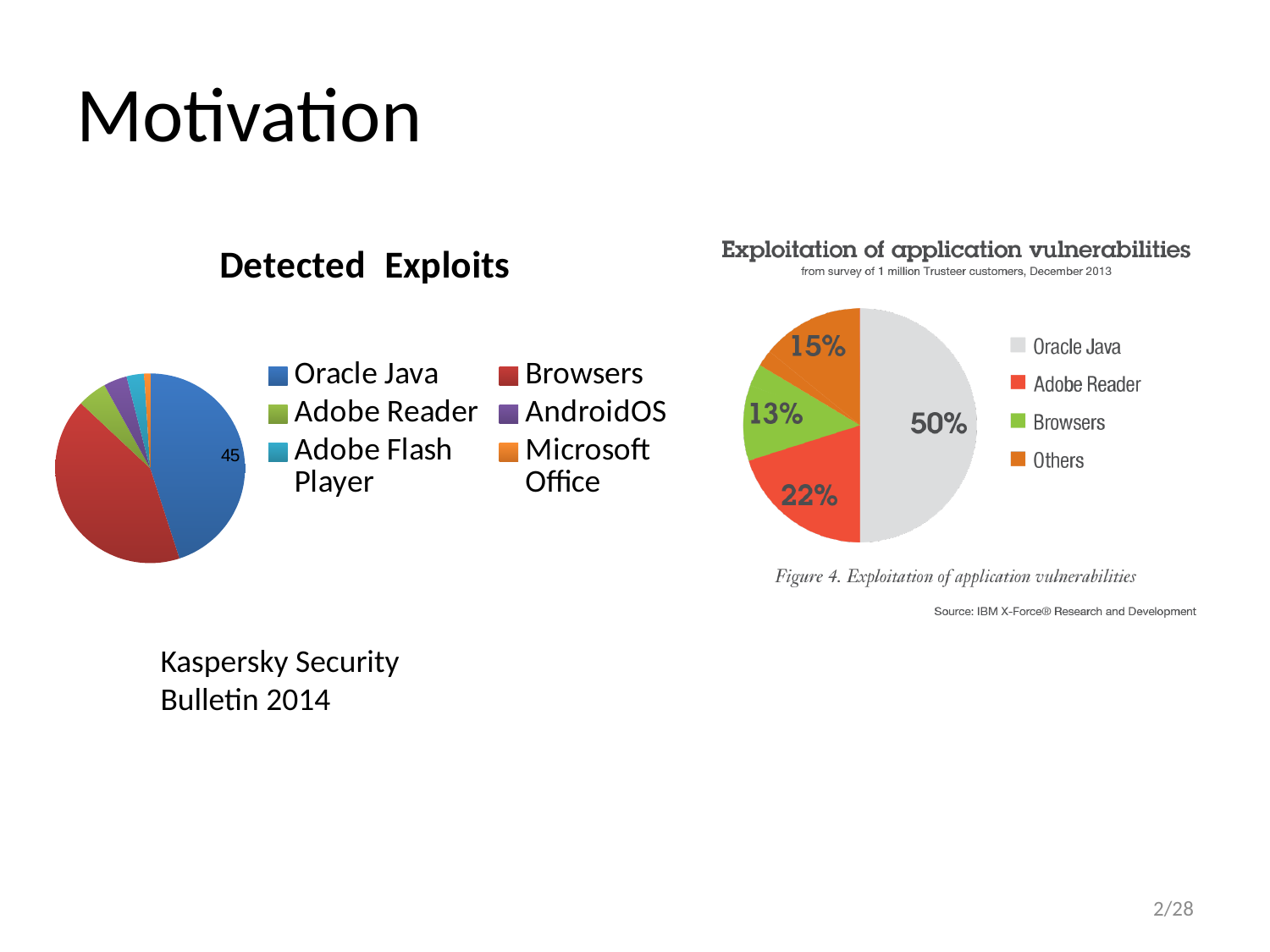
In the "Exploitation of application vulnerabilities" chart, what is the value for Browsers? 13% How many slices does the "Exploitation of application vulnerabilities" pie chart have? 4 What kind of chart is the "Exploitation of application vulnerabilities" chart? pie chart In the "Exploitation of application vulnerabilities" chart, which category has the smallest share? Browsers In the "Detected Exploits" chart, which slice is larger, Oracle Java or Adobe Reader? Oracle Java In the "Exploitation of application vulnerabilities" chart, what share does Oracle Java have? 50% What kind of chart is the "Detected Exploits" chart? pie chart In the "Detected Exploits" chart, which category has the smallest slice? Microsoft Office In the "Detected Exploits" chart, what value is labelled on the Oracle Java slice? 45 In the "Exploitation of application vulnerabilities" chart, what is the difference between the Oracle Java and Adobe Reader shares? 28% How many categories does the legend of the "Detected Exploits" chart list? 6 In the "Exploitation of application vulnerabilities" chart, what is the value for Adobe Reader? 22%